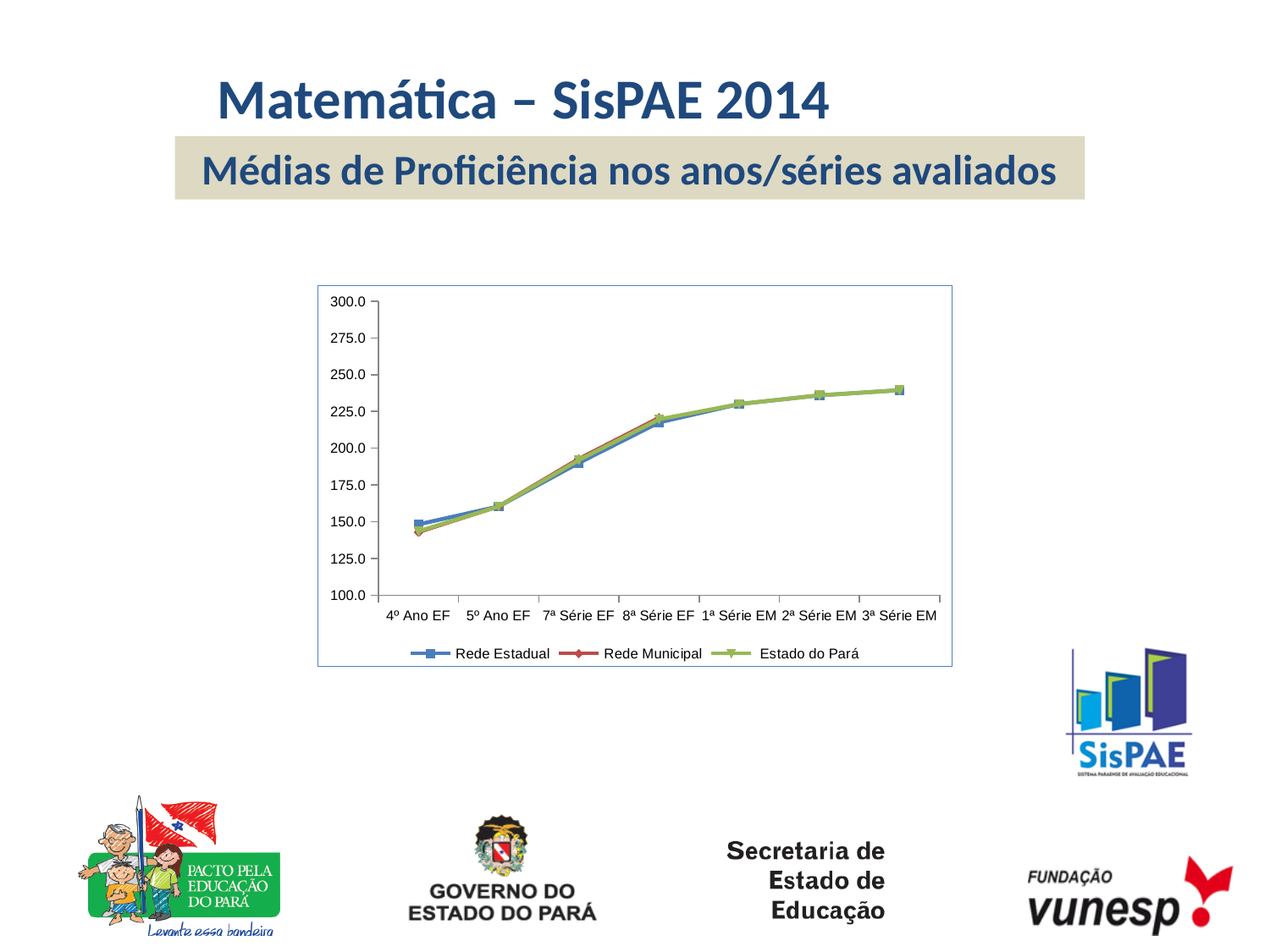
Which series is shown in green in the legend? Estado do Pará What kind of chart is shown on the slide? line chart Is the value for Rede Estadual at 7ª Série EF greater or less than 175? greater Is the value for Estado do Pará at 5º Ano EF greater or less than 150? greater Is the value for Estado do Pará at 3ª Série EM greater or less than 250? less What subject and year does the slide title refer to? Matemática – SisPAE 2014 Which category has the lowest proficiency averages? 4º Ano EF How many series does the legend list? 3 Do the proficiency averages rise or fall from 4º Ano EF to 3ª Série EM? rise How many years/series (categories) are plotted along the x axis? 7